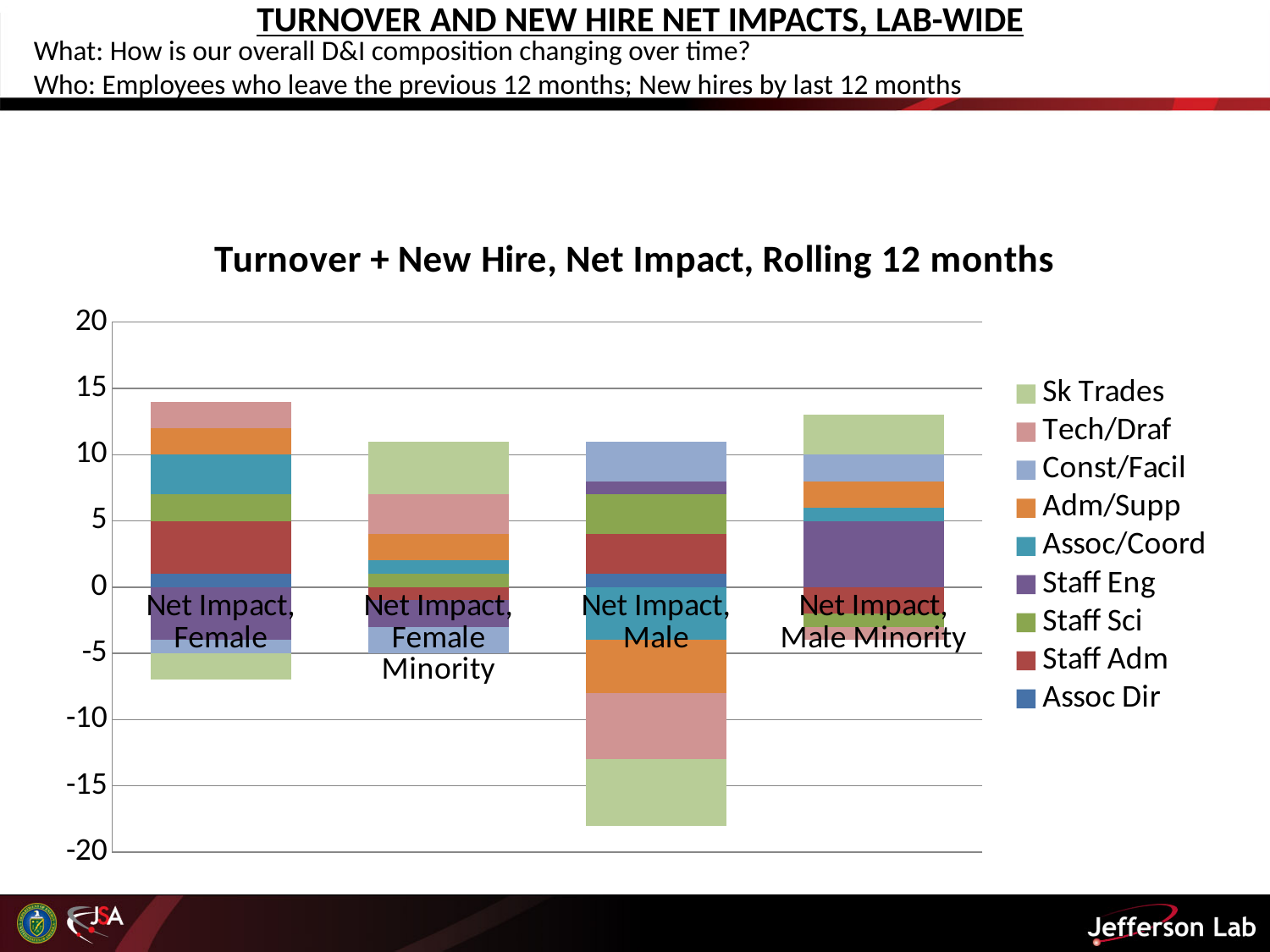
Is the top of the positive stack for Net Impact, Female greater or less than 10? greater How many series does the chart's legend list? 9 How many categories are shown along the x axis of the chart? 4 Is the bottom of the negative stack for Net Impact, Female greater or less than -5? less What is the title of the chart? Turnover + New Hire, Net Impact, Rolling 12 months Which series is listed first in the chart's legend? Sk Trades Is the top of the positive stack for Net Impact, Male Minority greater or less than 10? greater What kind of chart is shown on the slide? stacked bar chart Which category's negative stack extends further below zero: Net Impact, Male or Net Impact, Female? Net Impact, Male Which category has the largest negative (below zero) stack? Net Impact, Male